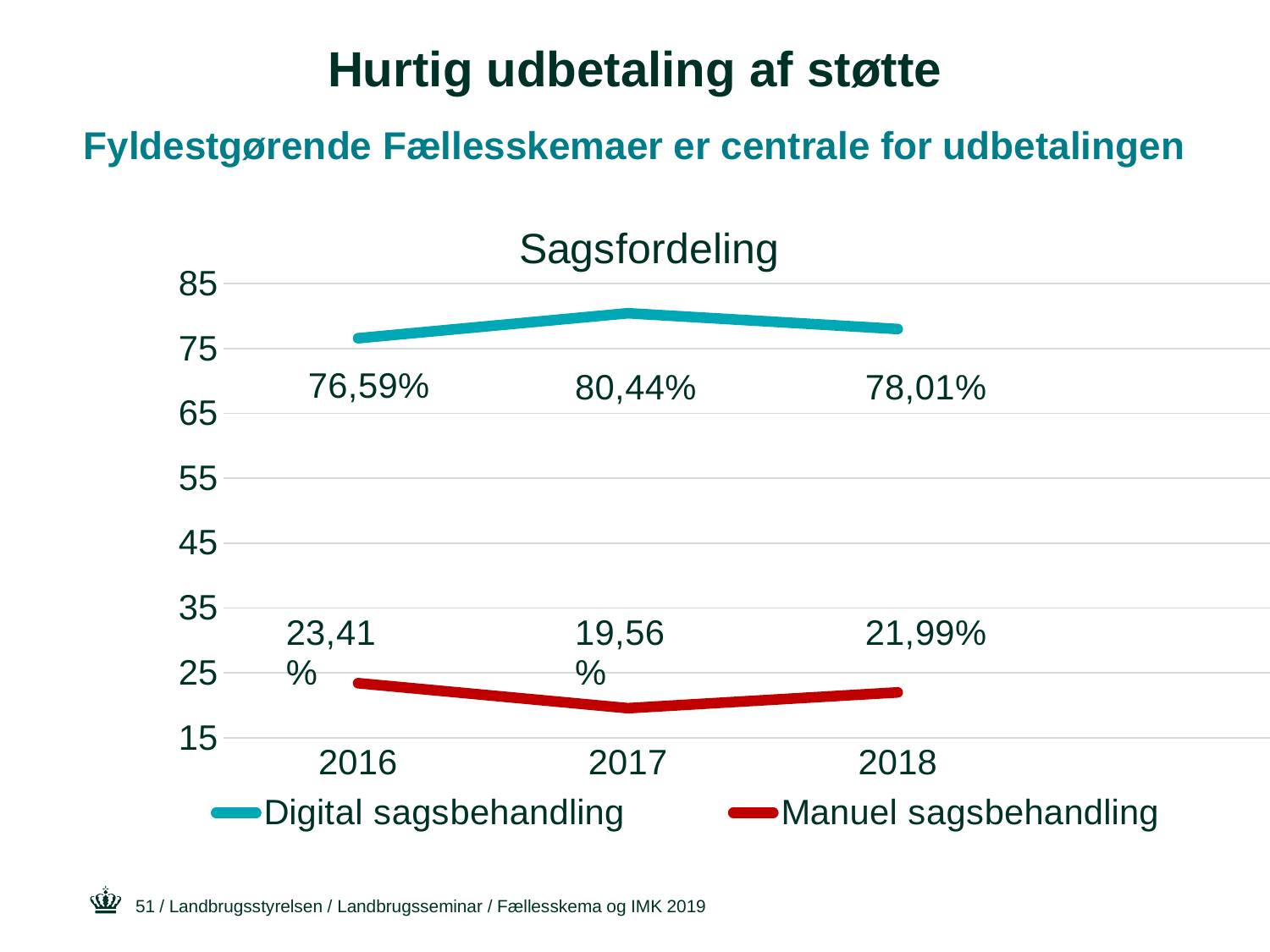
What is the value for Digital sagsbehandling in 2016? 76,59% What is the title of the chart? Sagsfordeling What is the value for Manuel sagsbehandling in 2018? 21,99% Which is larger: Manuel sagsbehandling in 2016 or in 2018? 2016 What is the value for Digital sagsbehandling in 2017? 80,44% How many years are shown on the x axis? 3 In which year is Digital sagsbehandling highest? 2017 Is the value for Digital sagsbehandling in 2018 greater or less than 75? greater How many series does the legend list? 2 What kind of chart is shown? line chart What is the difference between Digital sagsbehandling in 2017 and in 2016? 3,85% In which year is Manuel sagsbehandling lowest? 2017